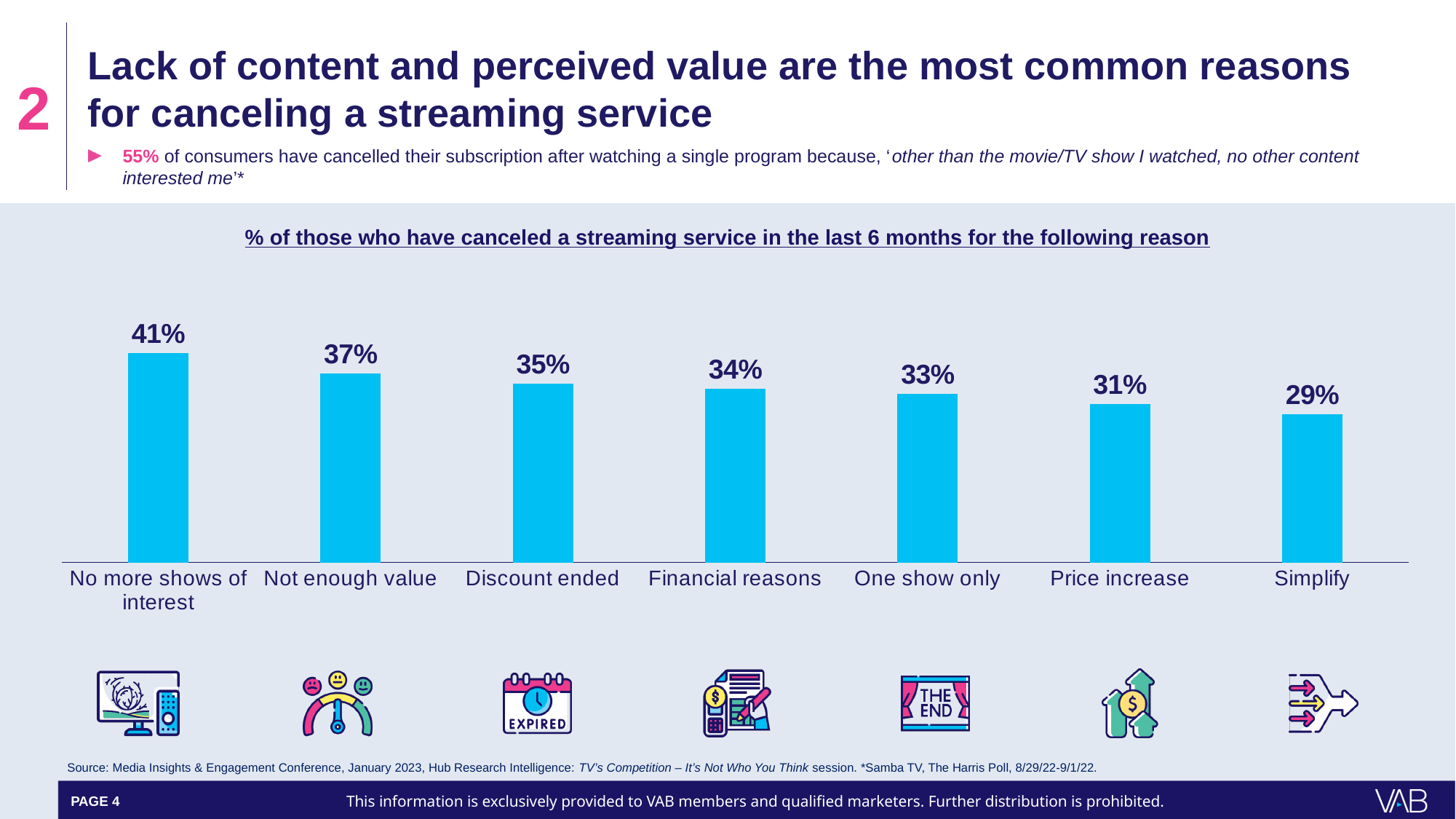
Which reason has the highest percentage in the chart? No more shows of interest Which has a higher value, 'One show only' or 'Price increase'? One show only What is the difference in percentage points between 'Not enough value' and 'Discount ended'? 2 What is the value shown for 'Price increase'? 31% Which reason has the lowest percentage in the chart? Simplify What is the value shown for 'Financial reasons'? 34% What is the title of the chart? % of those who have canceled a streaming service in the last 6 months for the following reason What type of chart is used on this slide? Bar chart What is the difference in percentage points between 'No more shows of interest' and 'Simplify'? 12 What percentage of those who canceled a streaming service cited 'No more shows of interest' as the reason? 41% Do the values rise or fall moving from left to right across the chart? Fall How many reasons (categories) are shown in the chart? 7